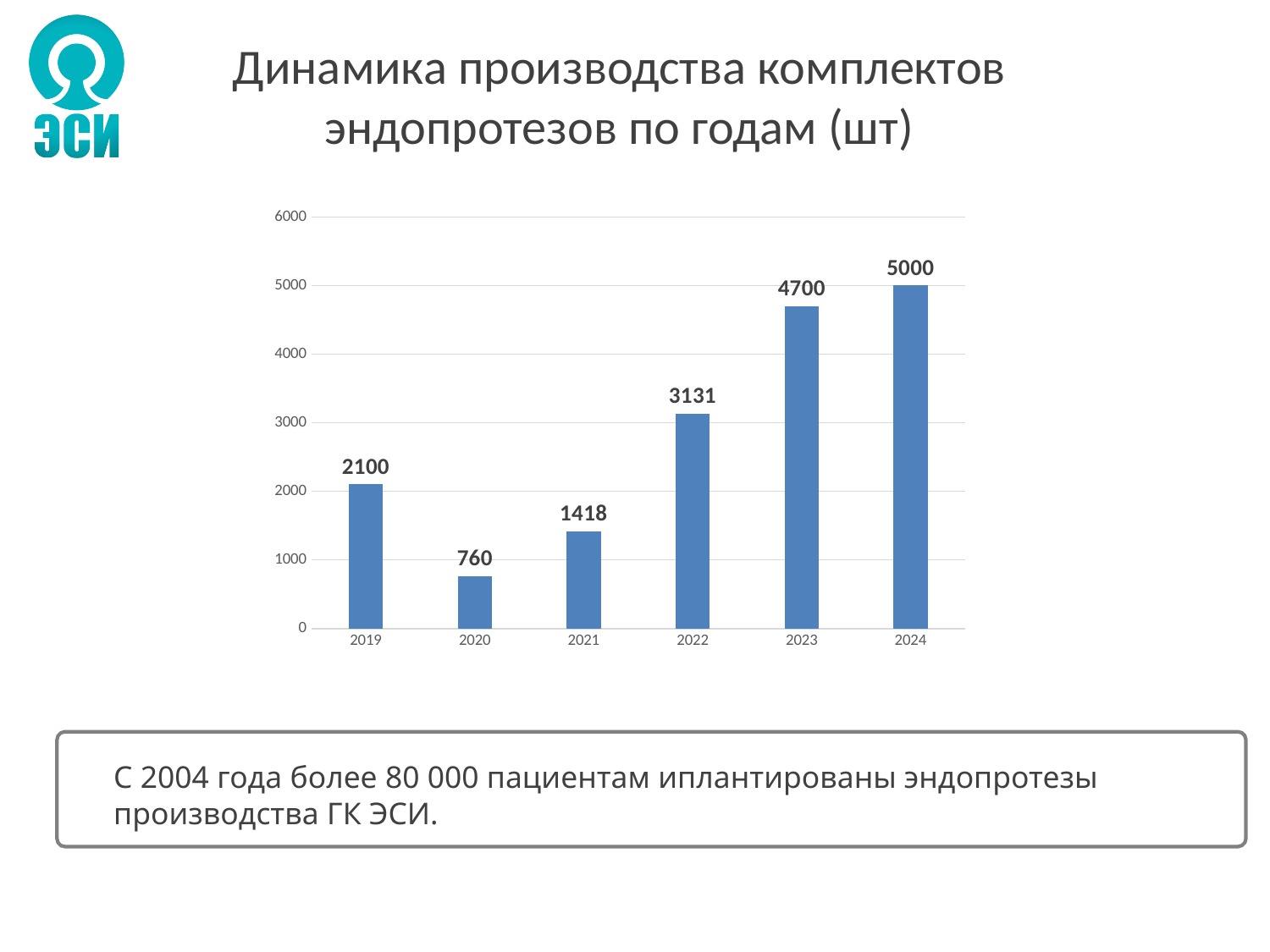
Which is larger, the value for 2019 or the value for 2021? 2019 What is the difference between the values for 2023 and 2022? 1569 How many years are shown on the x axis? 6 Which year has the highest value? 2024 Is the value for 2023 greater or less than 4000? greater Do the values rise or fall from 2020 to 2024? rise What is the difference between the values for 2019 and 2021? 682 Which year has the lowest value? 2020 What is the value for 2024? 5000 What is the value for 2022? 3131 What is the value for 2020? 760 What kind of chart is shown on the slide? bar chart